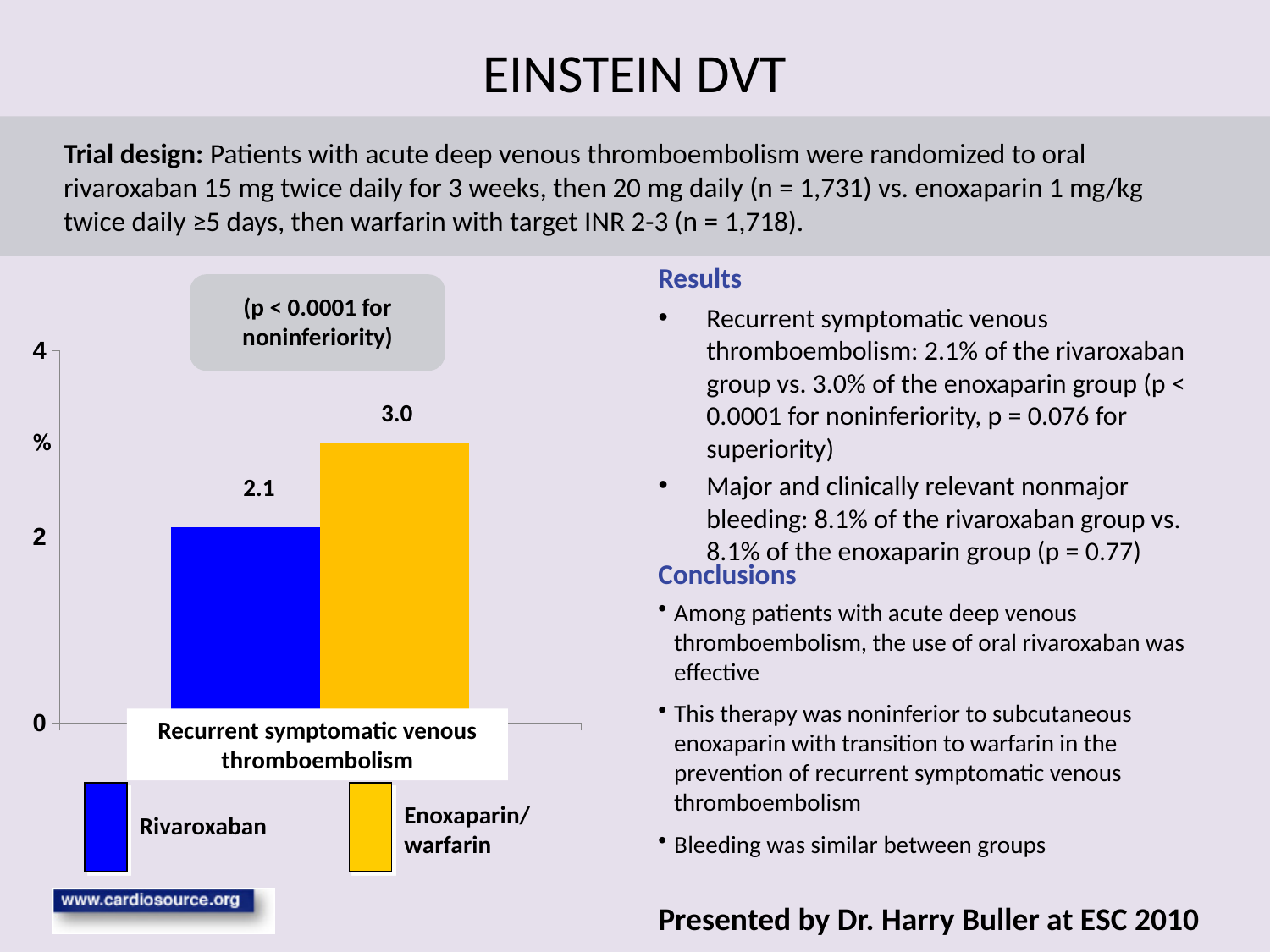
What kind of chart is shown on the slide? bar chart What colour is the Enoxaparin/warfarin bar in the chart? yellow What is the value for Enoxaparin/warfarin in the chart? 3.0 Which group has the higher rate of recurrent symptomatic venous thromboembolism in the chart? Enoxaparin/warfarin Is the value for Rivaroxaban larger or smaller than the value for Enoxaparin/warfarin? smaller What is the category label shown beneath the bars in the chart? Recurrent symptomatic venous thromboembolism What is the difference between the Enoxaparin/warfarin and Rivaroxaban values in the chart? 0.9 How many series does the chart legend list? 2 How many bars are plotted in the chart? 2 Is the value for Enoxaparin/warfarin greater or less than 2? greater Which group has the lower value in the chart? Rivaroxaban What is the value for Rivaroxaban in the chart? 2.1